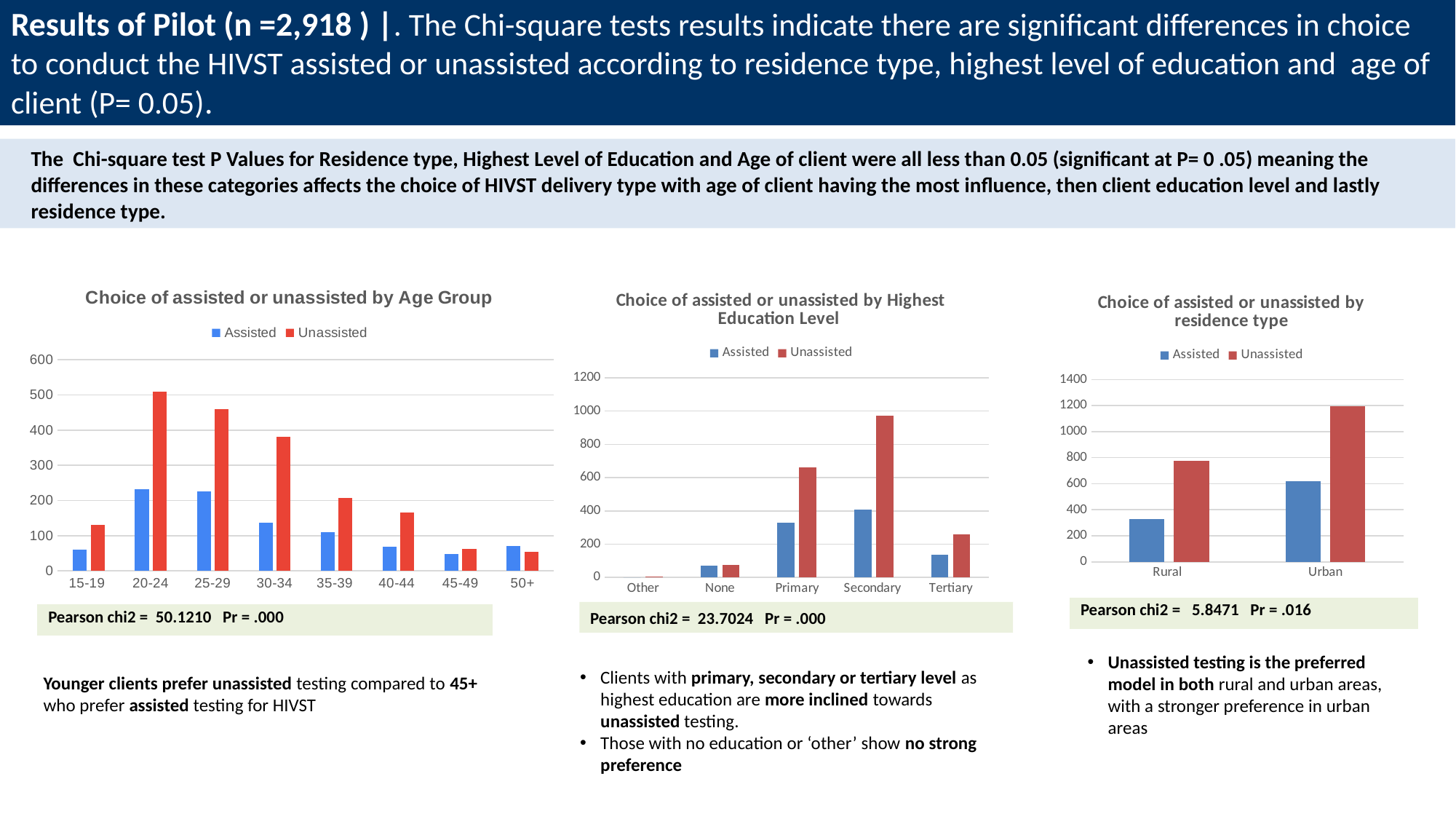
How many series does the legend list in the 'Choice of assisted or unassisted by Age Group' chart? 2 In the 'Choice of assisted or unassisted by Highest Education Level' chart, which education level has the highest Unassisted value? Secondary How many age group categories are shown in the 'Choice of assisted or unassisted by Age Group' chart? 8 What kind of chart is 'Choice of assisted or unassisted by Age Group'? bar chart In the 'Choice of assisted or unassisted by Highest Education Level' chart, is the Unassisted value for Secondary greater or less than 800? greater In the 'Choice of assisted or unassisted by Age Group' chart, which age group has the highest Unassisted value? 20-24 In the 'Choice of assisted or unassisted by Age Group' chart, which age group has the lowest Assisted value? 45-49 In the 'Choice of assisted or unassisted by Age Group' chart, which is larger for the 50+ group, Assisted or Unassisted? Assisted In the 'Choice of assisted or unassisted by residence type' chart, is the Unassisted value for Urban greater or less than 1000? greater What are the two legend entries in the 'Choice of assisted or unassisted by residence type' chart? Assisted and Unassisted How many education level categories are shown in the 'Choice of assisted or unassisted by Highest Education Level' chart? 5 In the 'Choice of assisted or unassisted by Age Group' chart, is the Unassisted value for 20-24 greater or less than 400? greater